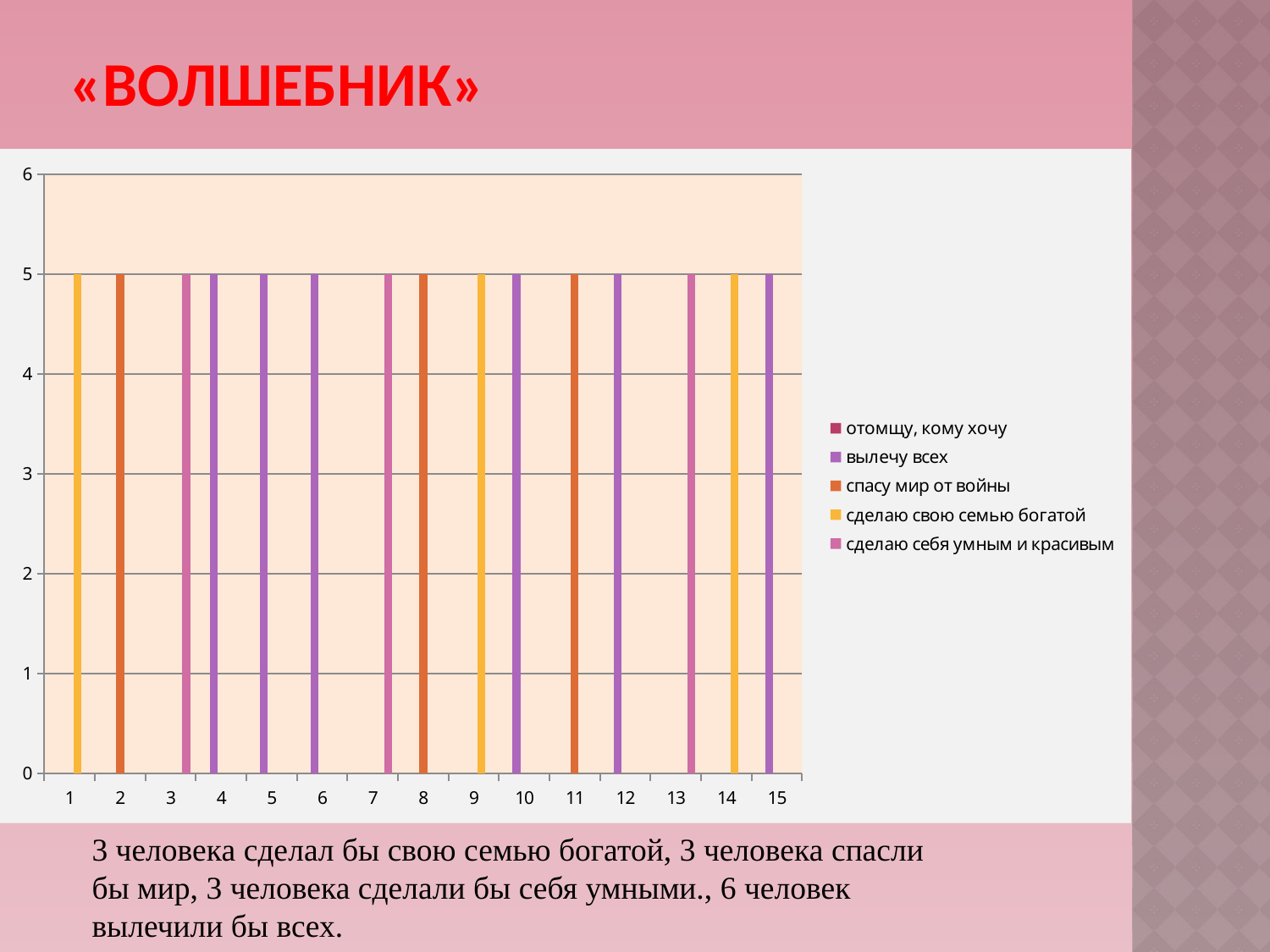
Do the bar values rise, fall, or stay the same from category 1 to category 15? stay the same How many categories are shown along the x axis of the chart? 15 Is the value for category 12 greater or less than 6? less Is the value for category 4 greater or less than 4? greater What kind of chart is shown on the slide? bar chart What is the value of the bar for category 1? 5 What is the value of the bar for category 15? 5 What is the first entry listed in the chart's legend? отомщу, кому хочу How many series does the chart's legend list? 5 What is the highest value shown on the vertical axis of the chart? 6 What is the value of the bar for category 8? 5